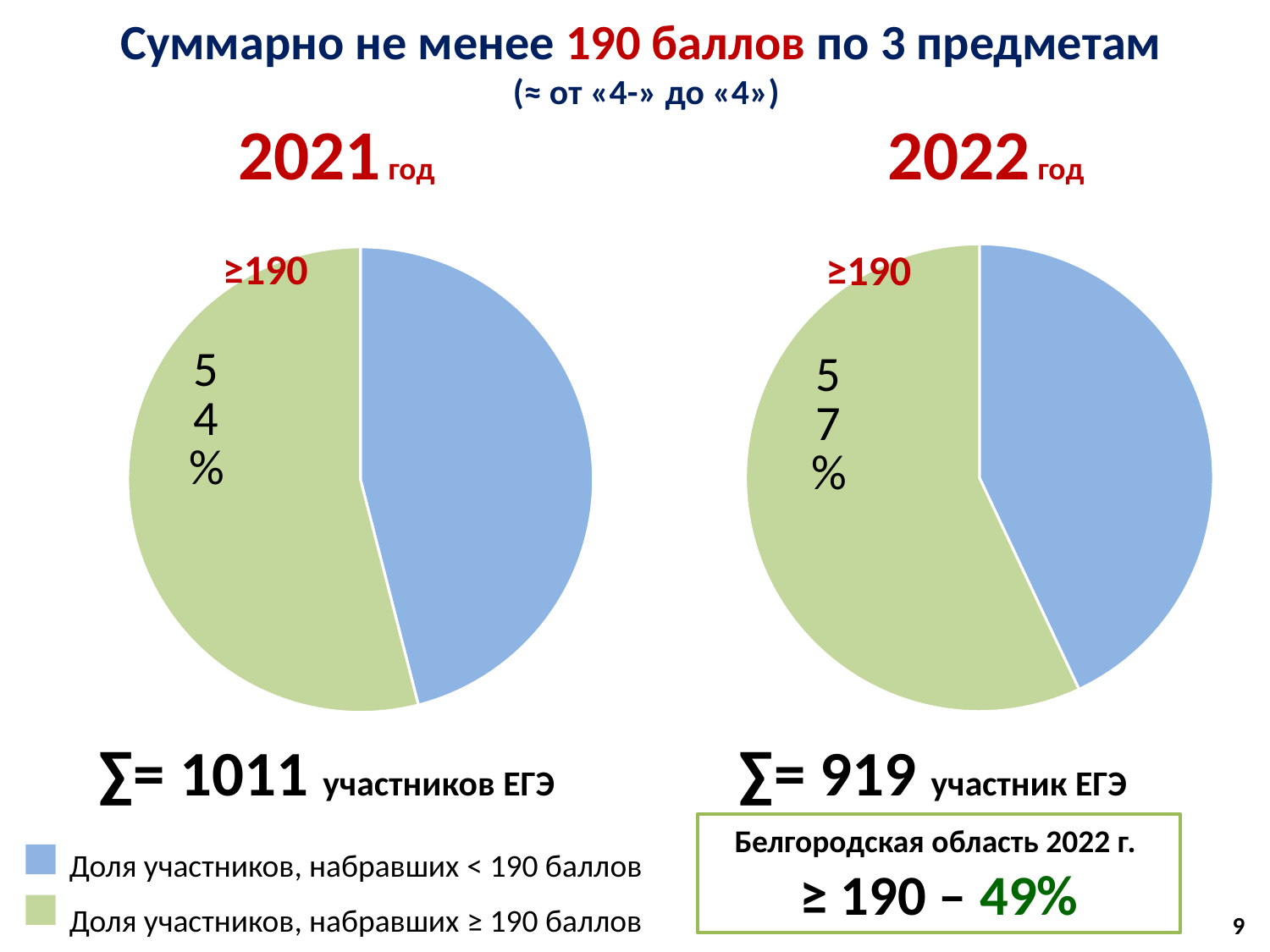
In the 2022 pie chart, is the share of participants scoring < 190 points greater or less than 50%? less In the 2022 pie chart, what share of participants scored ≥190 points? 57% Which colour in the legend represents the share of participants who scored < 190 points? Blue What kind of chart is used for the 2021 and 2022 data on this slide? Pie chart Which year has the larger share of participants scoring ≥190 points, 2021 or 2022? 2022 In the 2021 pie chart, is the share of participants scoring < 190 points greater or less than 50%? less How many EGE participants are reported in total under the 2021 pie chart? 1011 By how many percentage points did the share of participants scoring ≥190 points change from 2021 to 2022? 3 percentage points How many slices does the 2022 pie chart have? 2 In the 2021 pie chart, what share of participants scored ≥190 points? 54% How many entries does the legend at the bottom of the slide list? 2